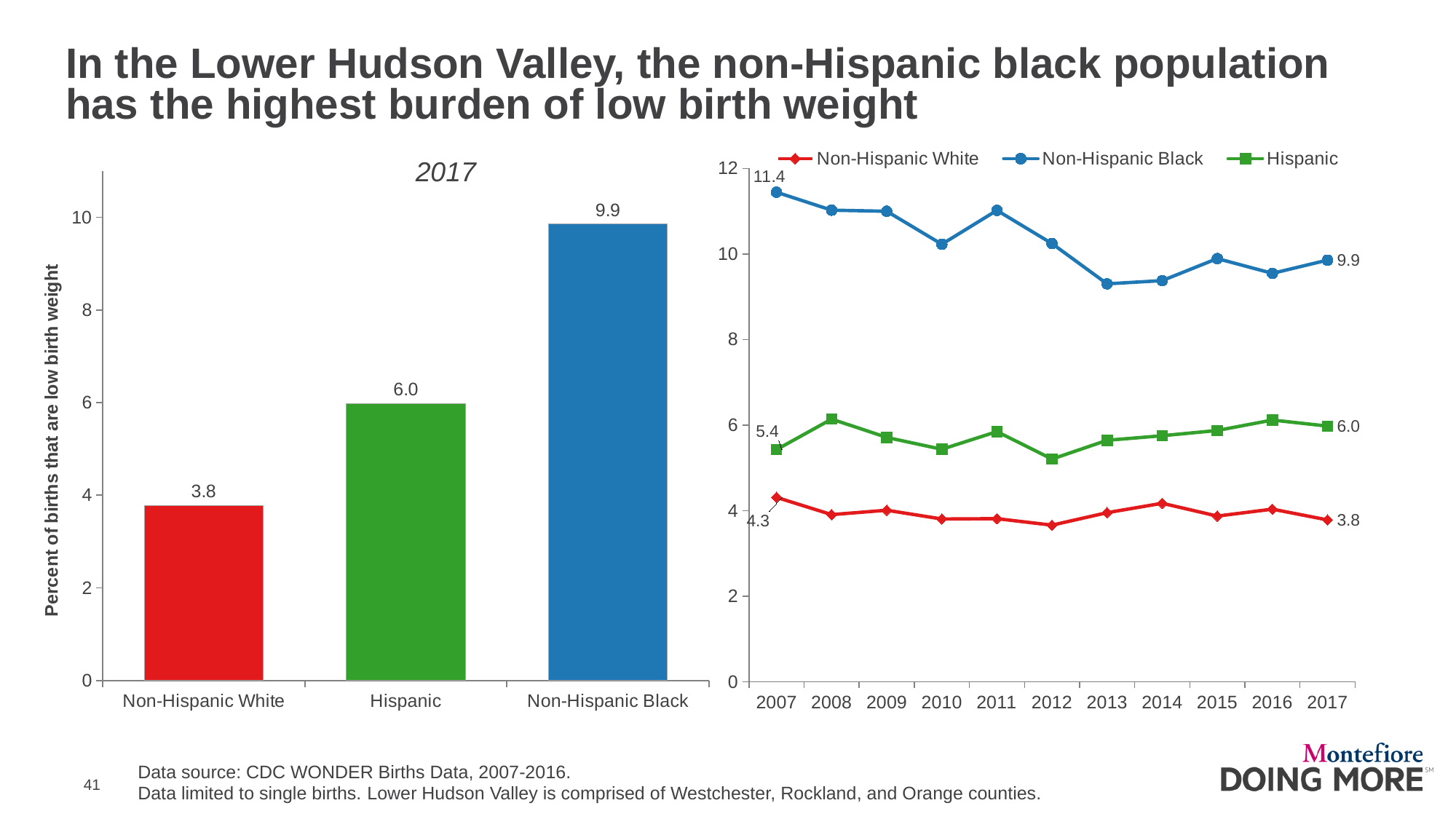
In the line chart on the right, what is the value for Non-Hispanic Black in 2007? 11.4 In the line chart on the right, is the value for Non-Hispanic Black in 2013 greater or less than 10? less In the 2017 bar chart on the left, how many categories are shown? 3 In the line chart on the right, does the Non-Hispanic Black series rise or fall from 2007 to 2017? fall In the 2017 bar chart on the left, what is the difference between the Non-Hispanic Black and Non-Hispanic White values? 6.1 In the line chart on the right, which series is shown in red? Non-Hispanic White In the line chart on the right, how many series does the legend list? 3 In the 2017 bar chart on the left, what is the value for Hispanic? 6.0 In the line chart on the right, what is the value for Hispanic in 2007? 5.4 In the 2017 bar chart on the left, which category has the lowest value? Non-Hispanic White What kind of chart is the chart on the left? bar chart In the 2017 bar chart on the left, which category has the highest value? Non-Hispanic Black